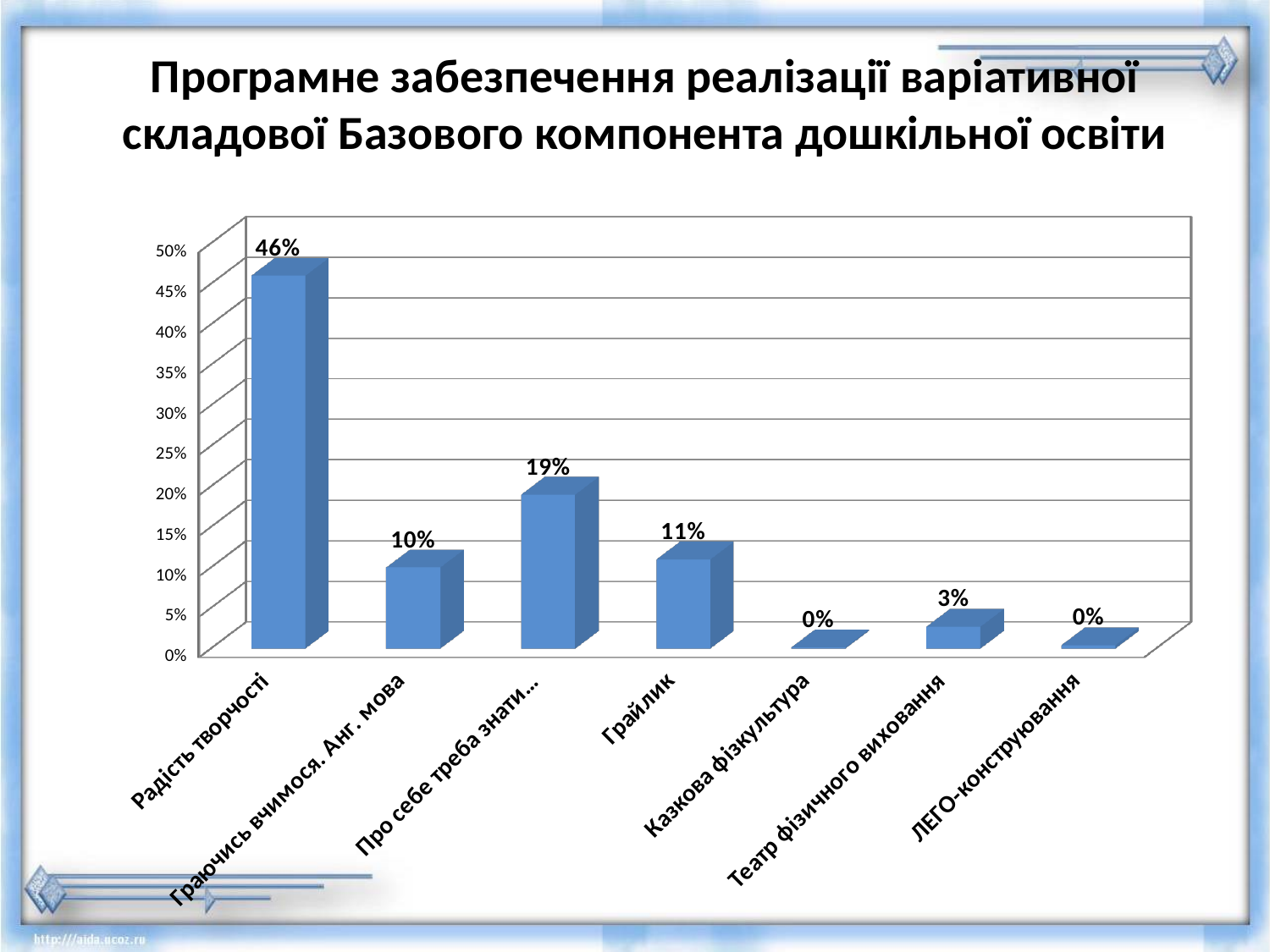
What is the difference between the values for Радість творчості and Про себе треба знати…? 27% How many categories have a value of 0%? 2 Which category has the highest value? Радість творчості How many categories are shown on the x axis? 7 What kind of chart is shown on the slide? Bar chart What is the highest value shown on the vertical axis? 50% What is the value for Театр фізичного виховання? 3% What is the difference between the values for Грайлик and Театр фізичного виховання? 8% What is the value for Граючись вчимося. Анг. мова? 10% Which is larger, the value for Про себе треба знати… or the value for Грайлик? Про себе треба знати… What is the value for Грайлик? 11% What is the value for Радість творчості? 46%